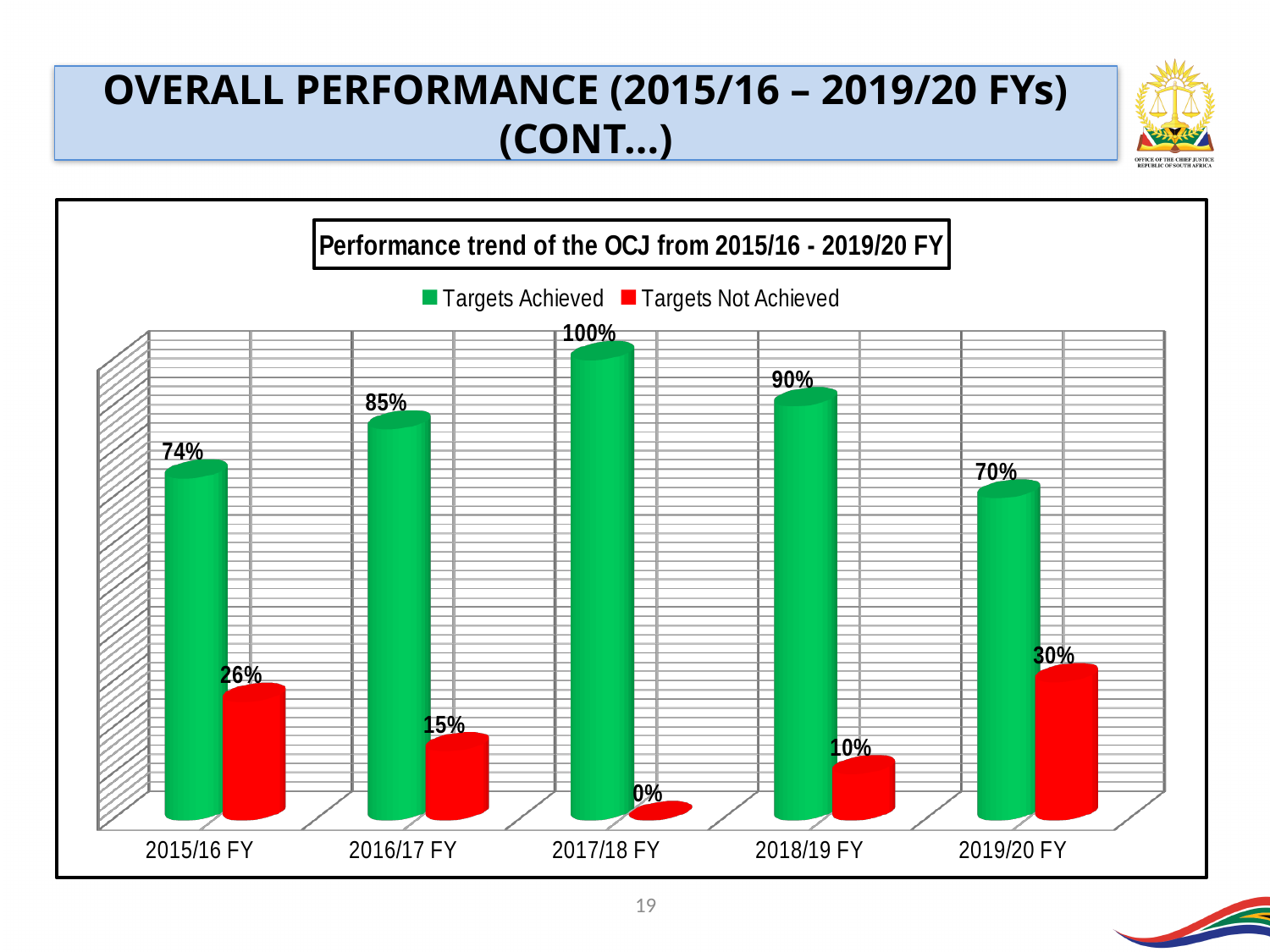
Which financial year has the lowest value for Targets Not Achieved? 2017/18 FY How many financial years are shown on the x axis? 5 What is the difference between Targets Achieved in 2016/17 FY and 2015/16 FY? 11% How many series does the legend list? 2 Which financial year has the highest value for Targets Achieved? 2017/18 FY What kind of chart is shown on the slide? Bar chart Does the value for Targets Achieved rise or fall from 2018/19 FY to 2019/20 FY? Fall What is the title of the chart? Performance trend of the OCJ from 2015/16 - 2019/20 FY What is the value for Targets Achieved in 2017/18 FY? 100% What is the value for Targets Achieved in 2019/20 FY? 70% What is the value for Targets Not Achieved in 2015/16 FY? 26% Which is larger: Targets Not Achieved in 2019/20 FY or in 2018/19 FY? 2019/20 FY